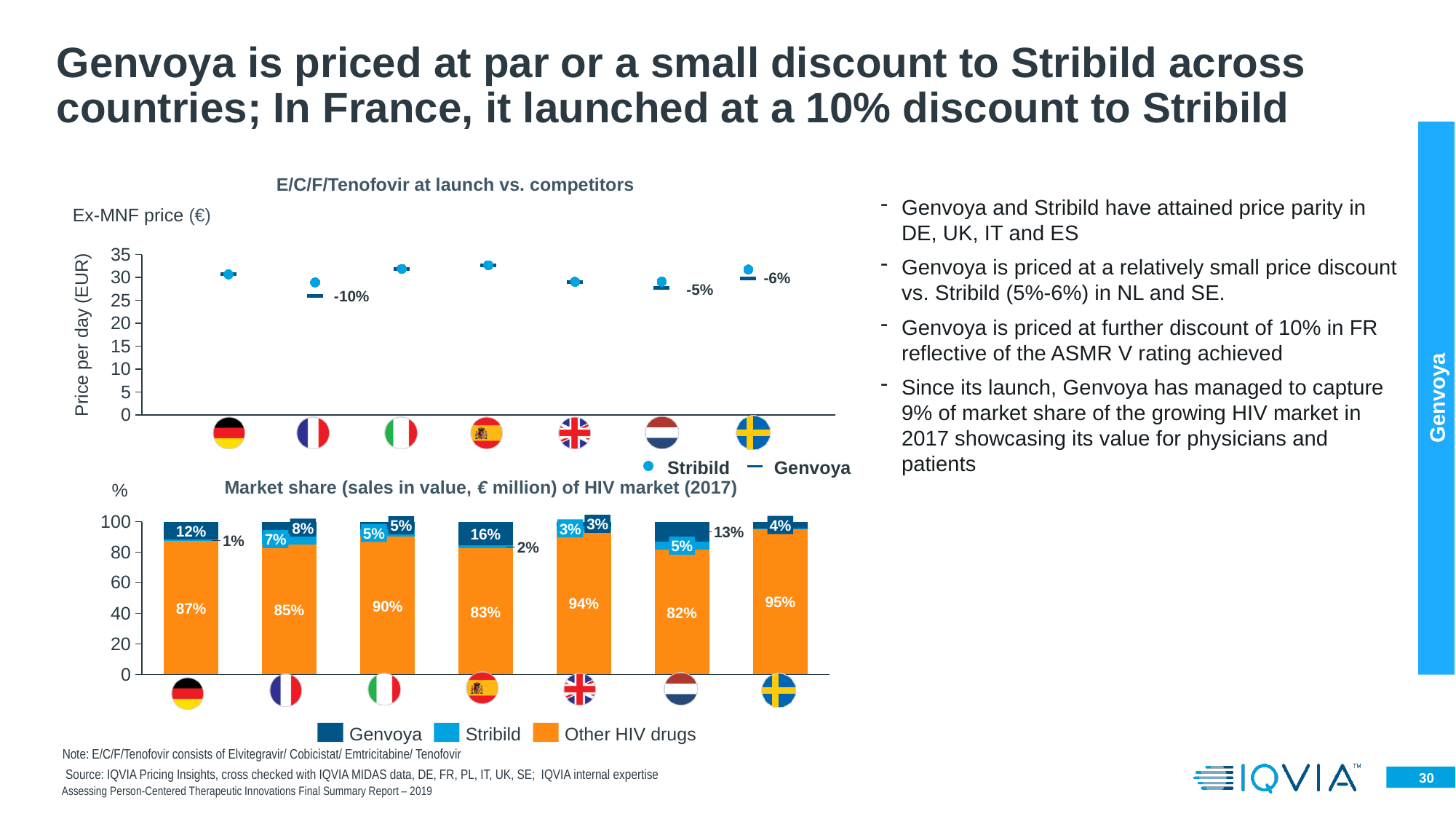
In the bottom market share chart, how many series does the legend list? 3 In the bottom market share chart, what is Stribild's share in Spain? 2% In the top chart 'E/C/F/Tenofovir at launch vs. competitors', is the Stribild price per day in Germany greater or less than 25? greater In the top chart 'E/C/F/Tenofovir at launch vs. competitors', how many series does the legend list? 2 In the bottom market share chart, is Genvoya's share larger in France or in Italy? France (8% vs 5%) What kind of chart is the bottom chart, 'Market share (sales in value, € million) of HIV market (2017)'? Stacked bar chart In the bottom market share chart, what is the difference between Stribild's share and Genvoya's share in Germany? 11 percentage points In the bottom market share chart, which country has the lowest share of Other HIV drugs? Netherlands (82%) In the bottom market share chart, what is Genvoya's share in the Netherlands? 13% In the bottom market share chart, what is the share of Other HIV drugs for Sweden (last bar)? 95% In the top chart 'E/C/F/Tenofovir at launch vs. competitors', what discount to Stribild is labelled for Genvoya in France? -10% In the top chart 'E/C/F/Tenofovir at launch vs. competitors', how many countries are plotted? 7